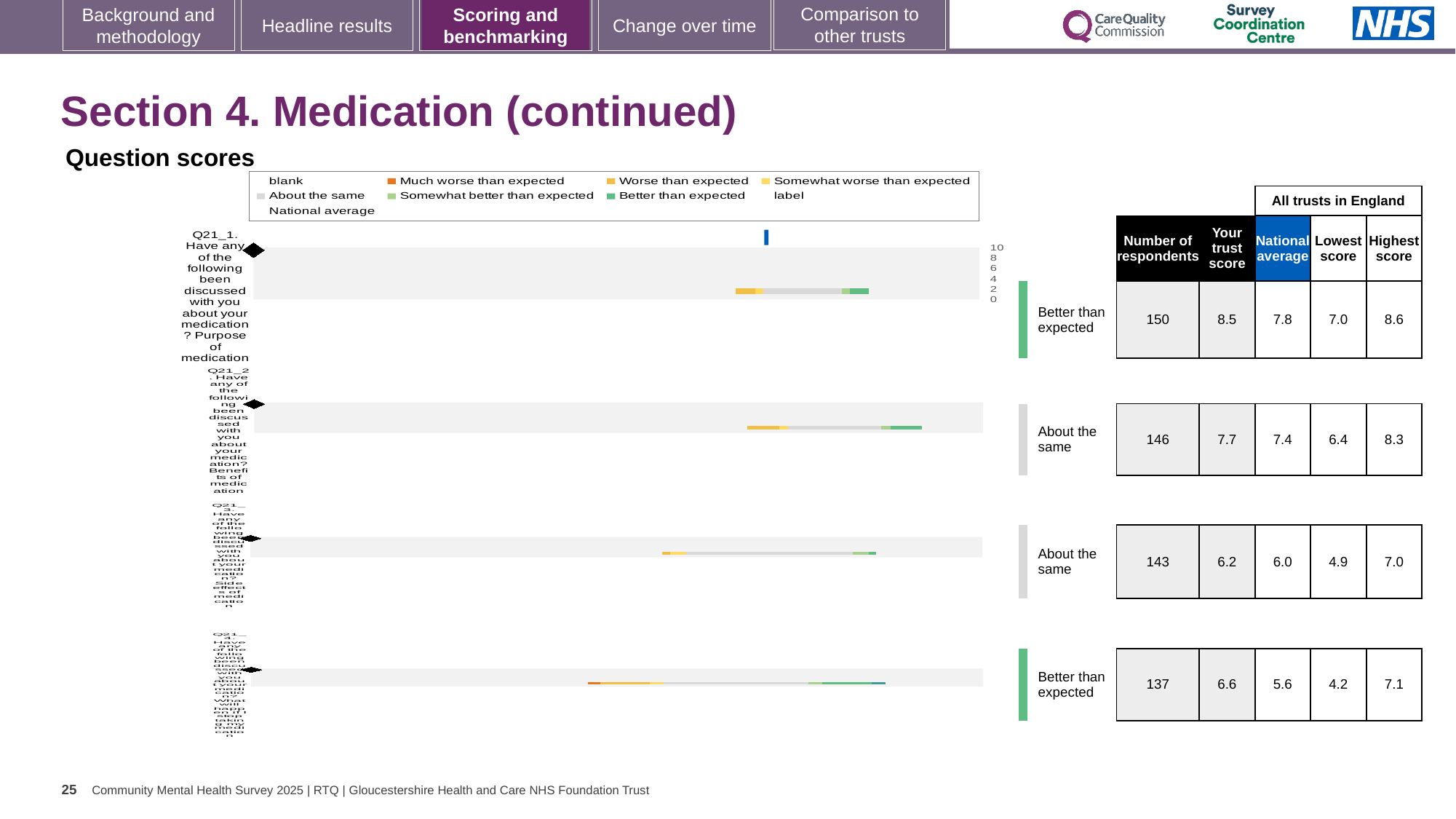
According to the table beside the chart, what is the difference between the trust score and the national average for Q21_1? 0.7 According to the table beside the chart, what is the national average for Q21_2 (Benefits of medication)? 7.4 How many entries does the legend of the 'Question scores' chart list? 9 In the legend of the 'Question scores' chart, what colour represents 'Better than expected'? green According to the table beside the chart, which question has the lowest trust score? Q21_3 In the legend of the 'Question scores' chart, what colour represents 'Much worse than expected'? orange What kind of chart is shown under 'Question scores'? bar chart According to the table beside the chart, what is the trust score for Q21_1 (Purpose of medication)? 8.5 According to the table beside the chart, is the trust score for Q21_4 larger or smaller than its national average? larger How many question bars are plotted in the 'Question scores' chart? 4 According to the table beside the chart, which question has the highest trust score? Q21_1 According to the table beside the chart, how many respondents answered Q21_4? 137